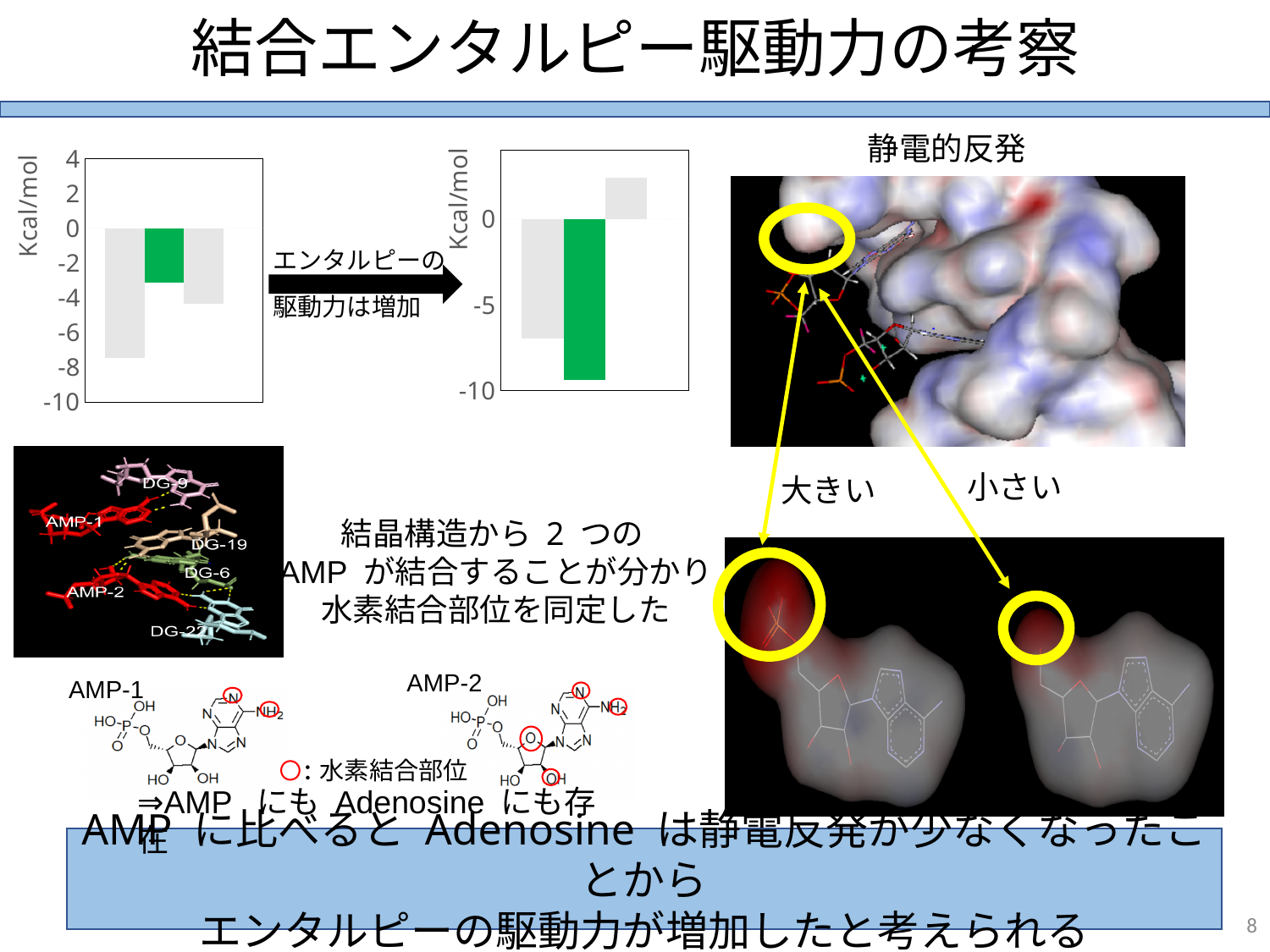
What is the y-axis label of the left chart? Kcal/mol In the right chart, is the value of the green bar greater or less than -5? less In the right chart, which bar has the lowest value: the leftmost gray bar, the green bar, or the rightmost gray bar? the green bar In the left chart, which bar has the lowest value: the leftmost gray bar, the green bar, or the rightmost gray bar? the leftmost gray bar In the right chart, which bar has the highest value: the leftmost gray bar, the green bar, or the rightmost gray bar? the rightmost gray bar How many bars does the left chart show? 3 How many bars does the right chart show? 3 In the left chart, is the value of the green bar greater or less than -4? greater In the right chart, is the value of the rightmost gray bar greater or less than 0? greater What type of chart is the left chart on the slide? bar chart In the left chart, which is larger, the green bar or the leftmost gray bar? the green bar